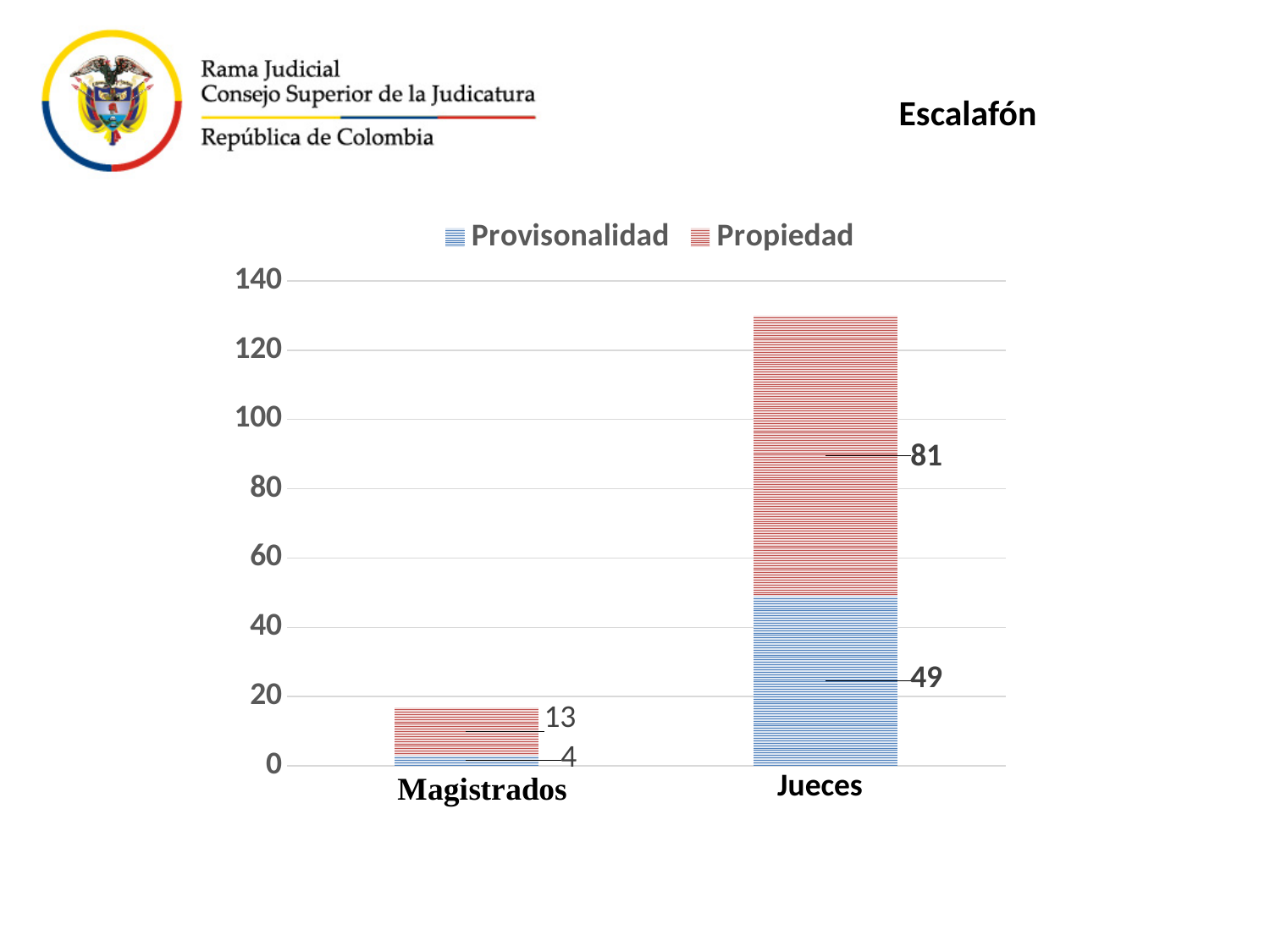
What is the total of the stacked bar for Magistrados? 17 What kind of chart is shown on the slide? Stacked bar chart What is the Provisionalidad value for Jueces? 49 What is the Provisionalidad value for Magistrados? 4 How many series does the legend list? 2 Which category has the higher Provisionalidad value, Magistrados or Jueces? Jueces What is the title of the chart? Escalafón Which category has the lowest total stacked bar? Magistrados What is the Propiedad value for Jueces? 81 What is the difference between the Propiedad values for Jueces and Magistrados? 68 What is the Propiedad value for Magistrados? 13 What is the total of the stacked bar for Jueces? 130